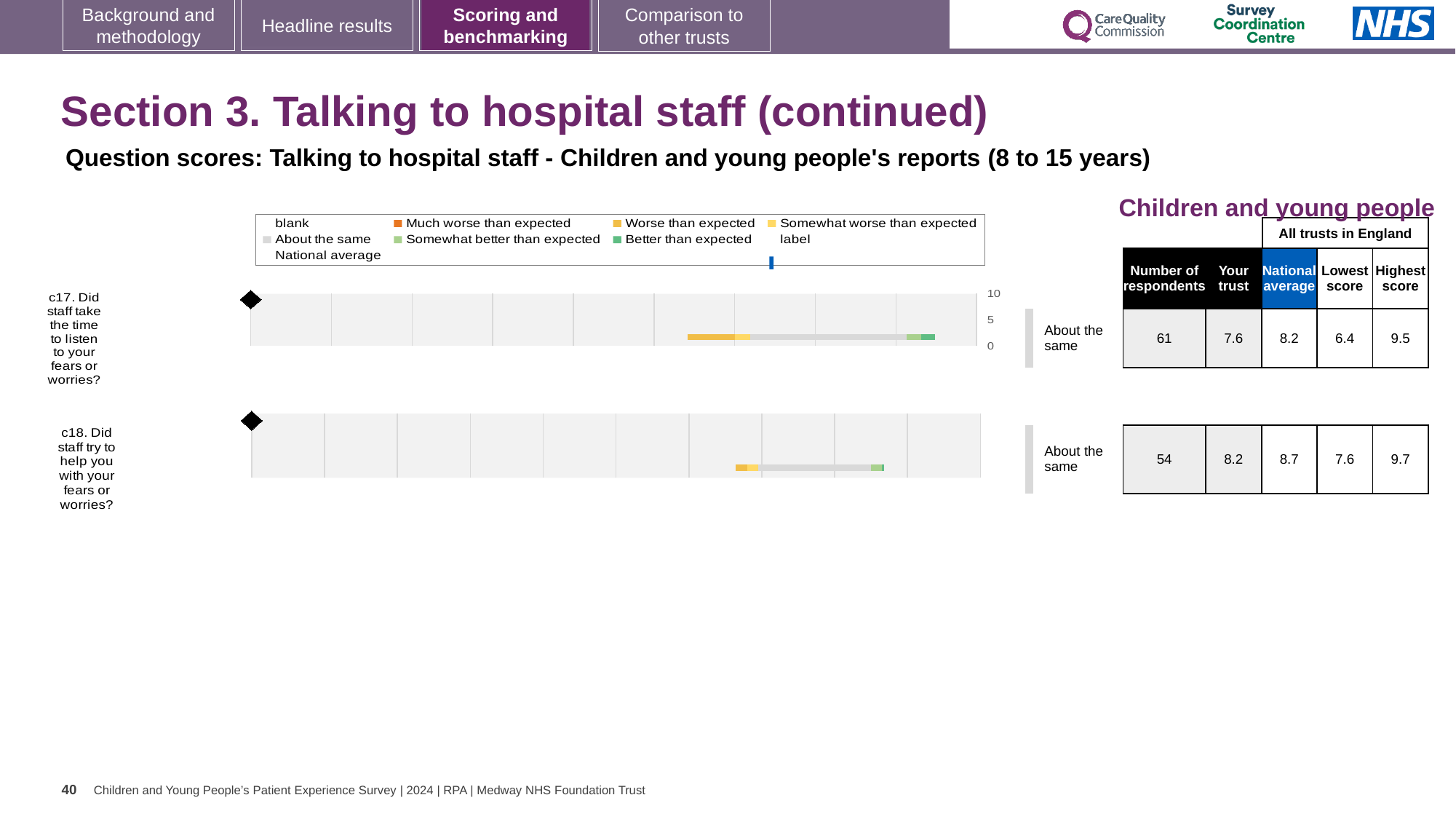
For c17, how much higher is the national average than the 'Your trust' score? 0.6 For c18, what is the highest score among all trusts in England? 9.7 For c18 (Did staff try to help you with your fears or worries?), what is the national average score? 8.7 For c17, which is larger: the 'Your trust' score or the national average? National average How many survey questions are plotted on the slide? 2 For c18, what is the difference between the highest score and the lowest score? 2.1 What kind of chart is used to show the question scores for c17 and c18? Bar chart What benchmark category is shown next to the c17 chart? About the same Which question, c17 or c18, has the higher 'Your trust' score? c18 For c17, what is the 'Your trust' score? 7.6 For c17 (Did staff take the time to listen to your fears or worries?), what is the number of respondents? 61 In the legend, what colour represents 'Much worse than expected'? Orange